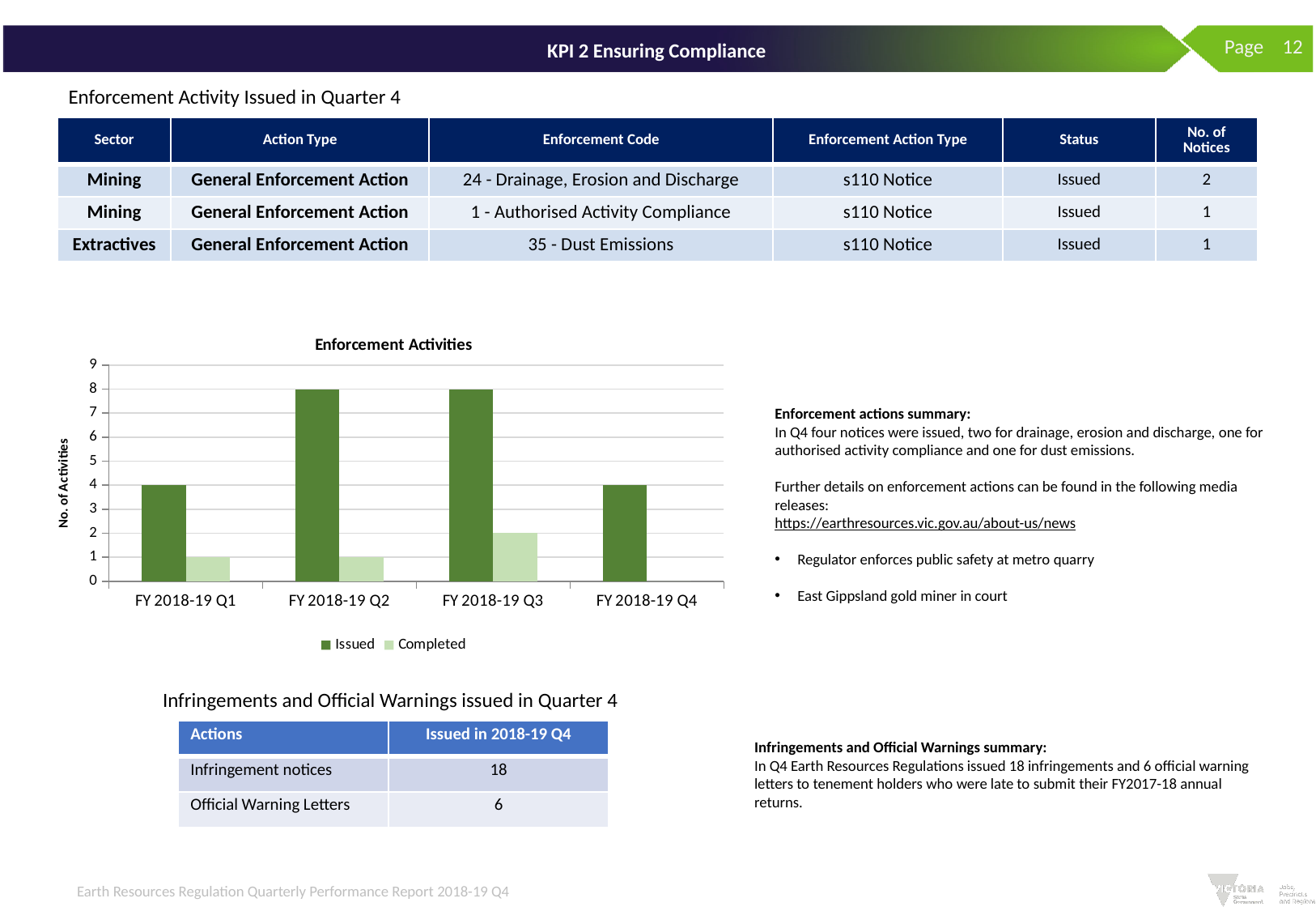
What type of chart is the 'Enforcement Activities' chart? bar chart In the 'Enforcement Activities' chart, does the Issued value rise or fall from FY 2018-19 Q3 to FY 2018-19 Q4? fall In the 'Enforcement Activities' chart, what is the Issued value for FY 2018-19 Q1? 4 In the 'Enforcement Activities' chart, is the Issued value for FY 2018-19 Q3 greater or less than 5? greater How many quarters are shown on the x axis of the 'Enforcement Activities' chart? 4 In the 'Enforcement Activities' chart, which quarter has the highest Completed value? FY 2018-19 Q3 In the 'Enforcement Activities' chart, what is the difference between the Issued and Completed values for FY 2018-19 Q3? 6 How many series does the legend of the 'Enforcement Activities' chart list? 2 In the 'Enforcement Activities' chart, what is the Issued value for FY 2018-19 Q2? 8 In the 'Enforcement Activities' chart, is the Issued value for FY 2018-19 Q2 larger than the Issued value for FY 2018-19 Q1? Yes In the 'Enforcement Activities' chart, what is the Completed value for FY 2018-19 Q3? 2 What is the y-axis label of the 'Enforcement Activities' chart? No. of Activities